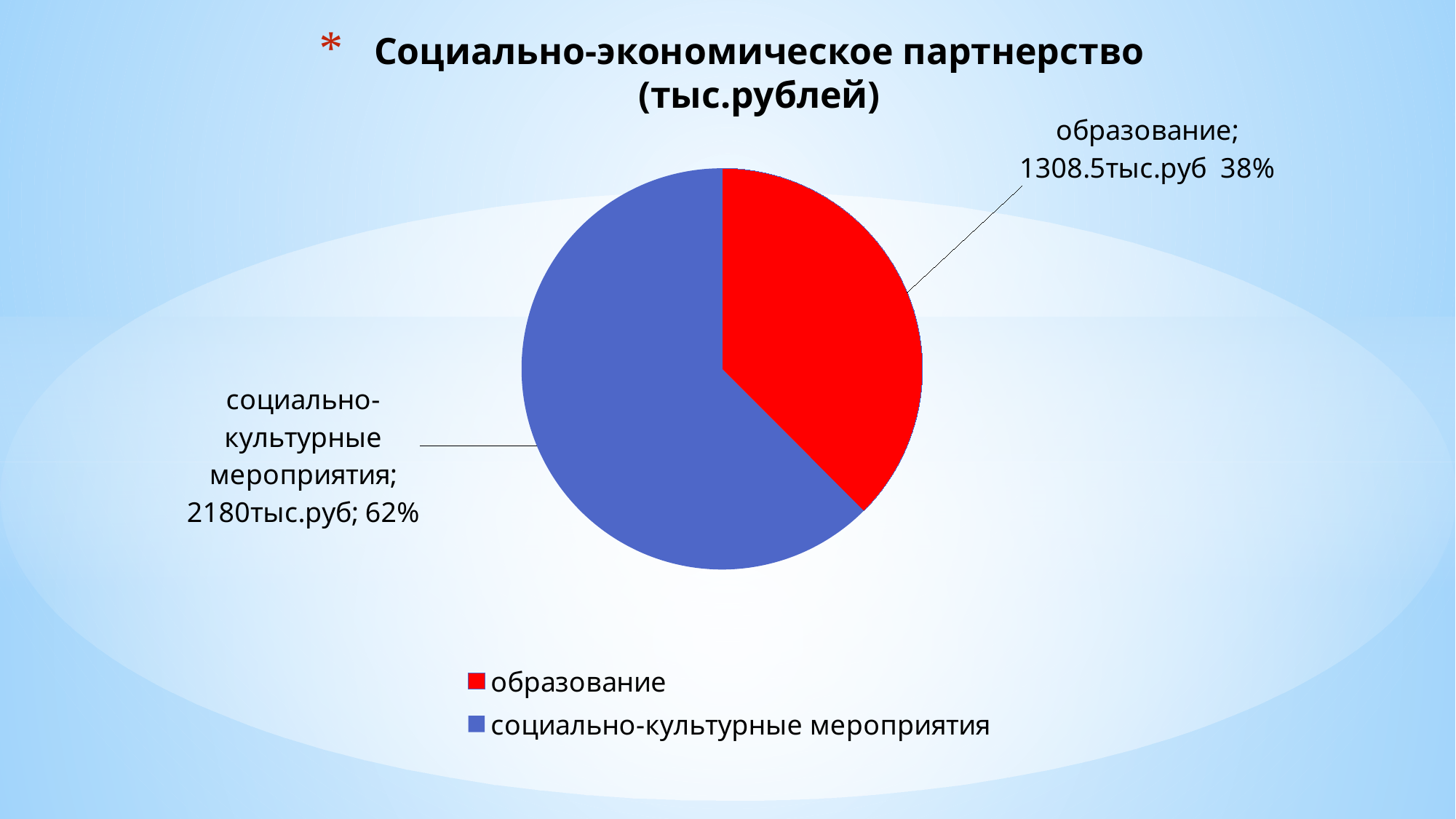
Which is larger, образование or социально-культурные мероприятия? социально-культурные мероприятия How many slices does the pie chart have? 2 What is the value for образование? 1308.5тыс.руб What is the value for социально-культурные мероприятия? 2180тыс.руб Which category has the largest slice? социально-культурные мероприятия What kind of chart is shown on the slide? pie chart What is the difference in value between социально-культурные мероприятия and образование? 871.5тыс.руб What share of the pie does образование take? 38% How many entries does the legend list? 2 Which category has the smallest slice? образование What share of the pie does социально-культурные мероприятия take? 62% What colour is the slice for образование? red